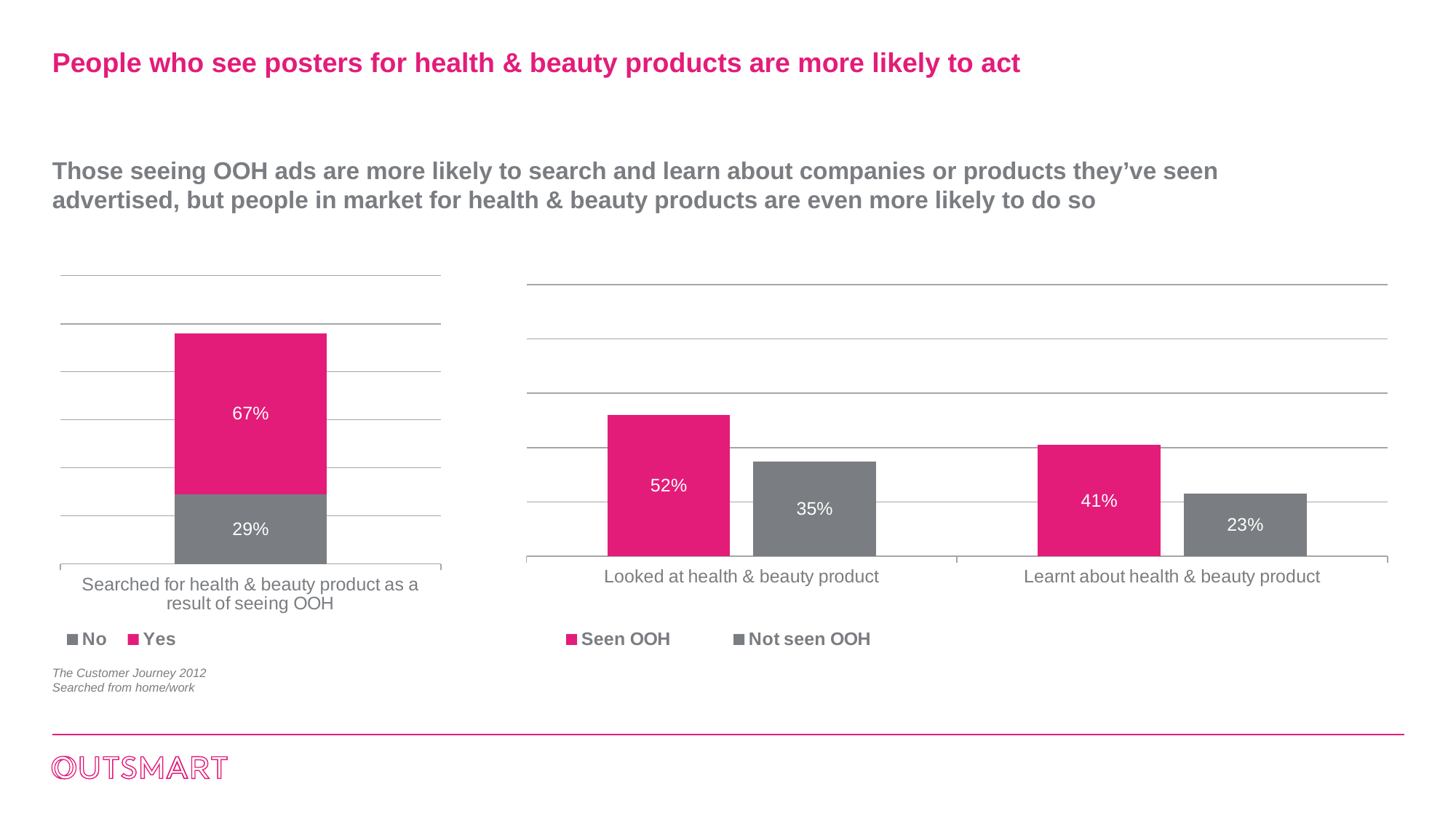
In the right chart, what is the value for "Seen OOH" for "Looked at health & beauty product"? 52% In the right chart, which category has the lowest "Not seen OOH" value? Learnt about health & beauty product In the right chart, which is larger for "Learnt about health & beauty product": "Seen OOH" or "Not seen OOH"? Seen OOH In the left chart, what is the value for "No"? 29% In the right chart, what is the difference between "Seen OOH" and "Not seen OOH" for "Looked at health & beauty product"? 17% What kind of chart is the left chart? Stacked bar chart How many categories are shown on the x axis of the right chart? 2 How many series does the legend of the right chart list? 2 In the left chart, what is the value for "Yes" for "Searched for health & beauty product as a result of seeing OOH"? 67% In the left chart, what is the difference between the "Yes" and "No" values? 38% In the right chart, what is the value for "Not seen OOH" for "Learnt about health & beauty product"? 23% In the left chart, what is the total of the stacked bar for "Searched for health & beauty product as a result of seeing OOH"? 96%